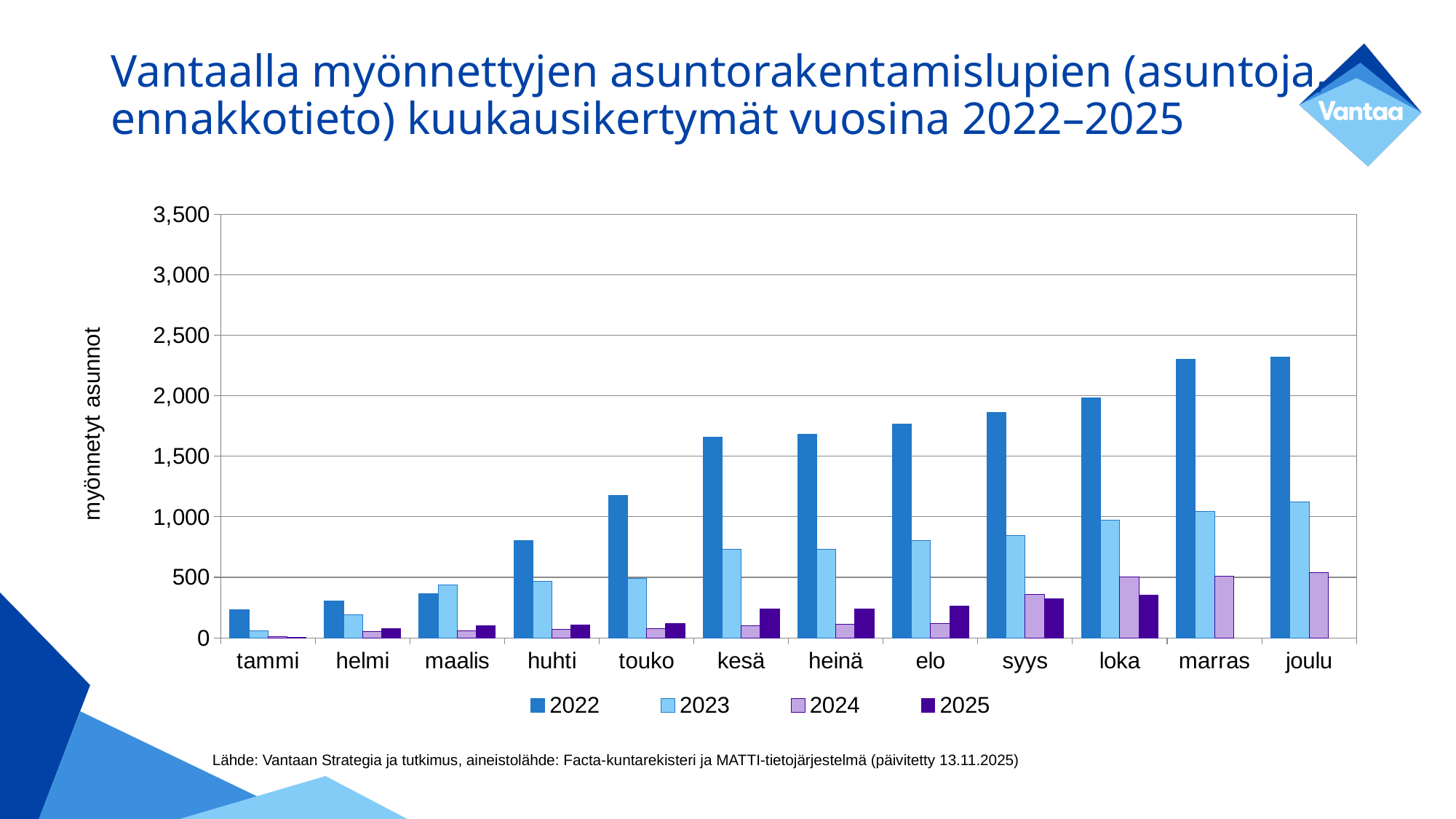
Which month has the highest value for the 2023 series? joulu Is the 2024 value for syys greater or less than 500? less What is the label on the y axis? myönnetyt asunnot What kind of chart is shown on the slide? bar chart How many series does the legend list? 4 Do the 2022 values rise or fall from tammi to joulu? rise Is the 2022 value for touko greater or less than 1,000? greater For maalis, which series has the larger value, 2022 or 2023? 2023 For huhti, which series has the larger value, 2022 or 2023? 2022 Which month has the lowest value for the 2022 series? tammi Is the 2022 value for kesä greater or less than 1,500? greater How many months are shown along the x axis? 12